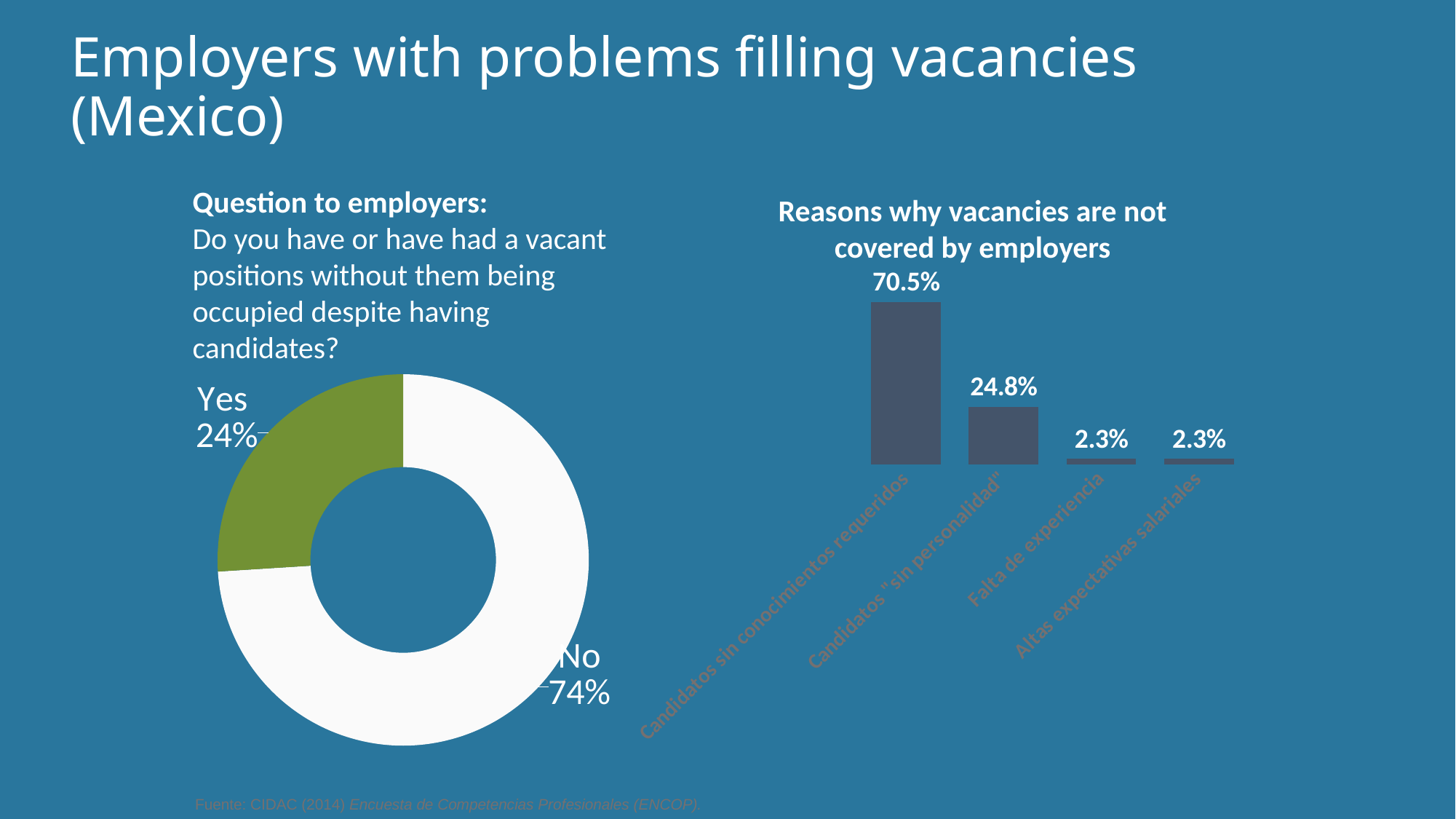
In the chart 'Reasons why vacancies are not covered by employers', what is the value for 'Candidatos "sin personalidad"'? 24.8% What kind of chart is the chart on the left of the slide? Doughnut chart What kind of chart is the chart on the right of the slide? Bar chart In the doughnut chart on the left, what is the difference between the No share and the Yes share? 50% In the chart 'Reasons why vacancies are not covered by employers', what is the difference between 'Candidatos sin conocimientos requeridos' and 'Candidatos "sin personalidad"'? 45.7% In the chart 'Reasons why vacancies are not covered by employers', what is the value for 'Falta de experiencia'? 2.3% In the doughnut chart on the left, which answer has the larger share, Yes or No? No In the chart 'Reasons why vacancies are not covered by employers', how many reasons (categories) are shown? 4 In the doughnut chart on the left, what share of employers answered Yes? 24% In the chart 'Reasons why vacancies are not covered by employers', which reason has the highest value? Candidatos sin conocimientos requeridos In the chart 'Reasons why vacancies are not covered by employers', what is the value for 'Candidatos sin conocimientos requeridos'? 70.5% In the doughnut chart on the left, what share of employers answered No? 74%